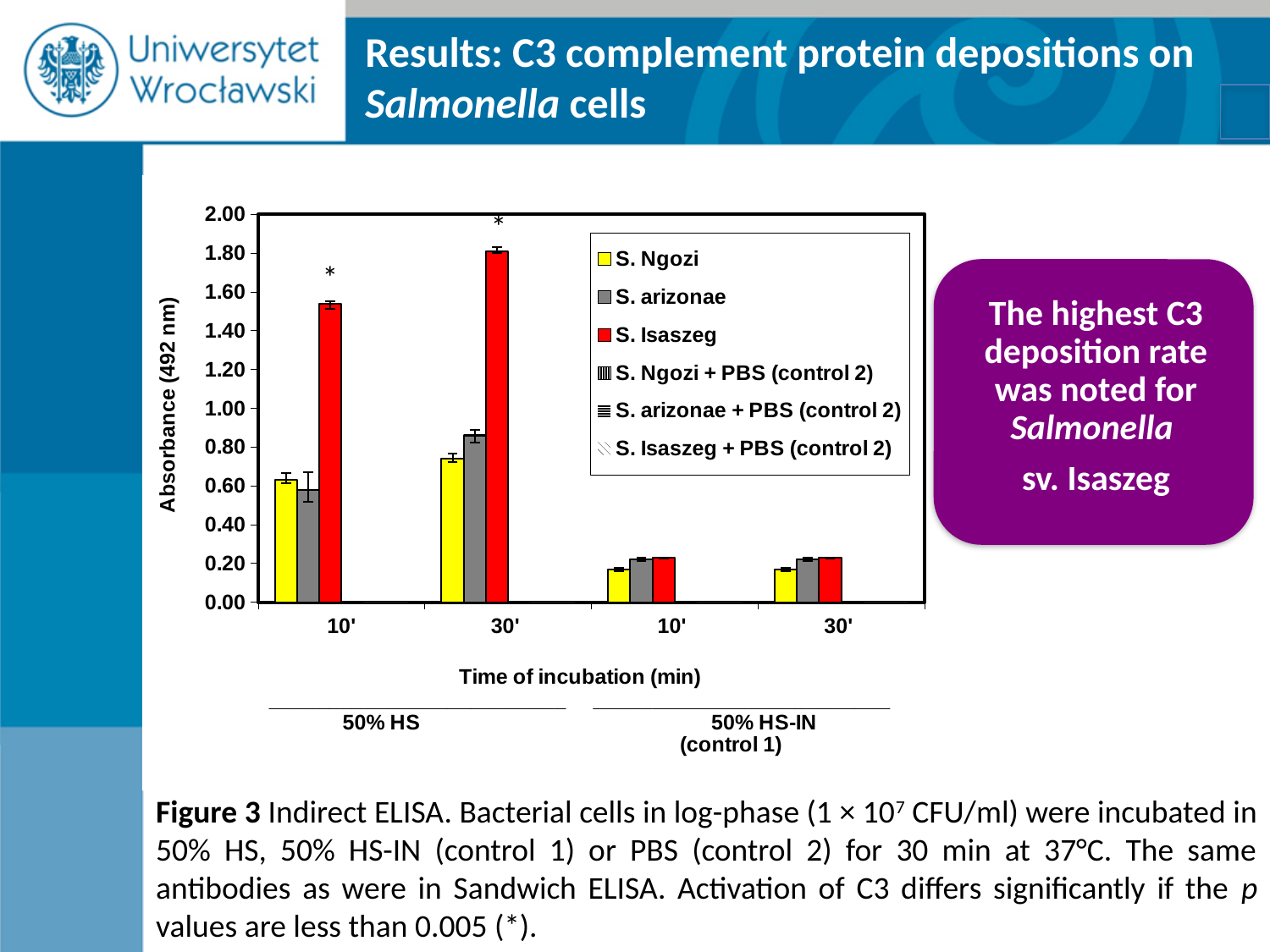
What kind of chart is shown on the slide? bar chart Under 50% HS, is the S. Isaszeg bar at 30' greater or less than 1.60? greater How many time-point categories are shown along the x axis? 4 What is the label of the y axis? Absorbance (492 nm) Under 50% HS, does the S. Isaszeg absorbance rise or fall from 10' to 30'? rise How many series does the chart legend list? 6 Under 50% HS at 30', which bar is taller: S. Isaszeg or S. Ngozi? S. Isaszeg Under 50% HS, is the S. Isaszeg bar at 10' greater or less than 1.40? greater Under 50% HS, is the S. Ngozi bar at 10' greater or less than 0.80? less Under 50% HS, is the S. arizonae bar taller at 10' or at 30'? 30' Which series has the highest bar in the chart? S. Isaszeg